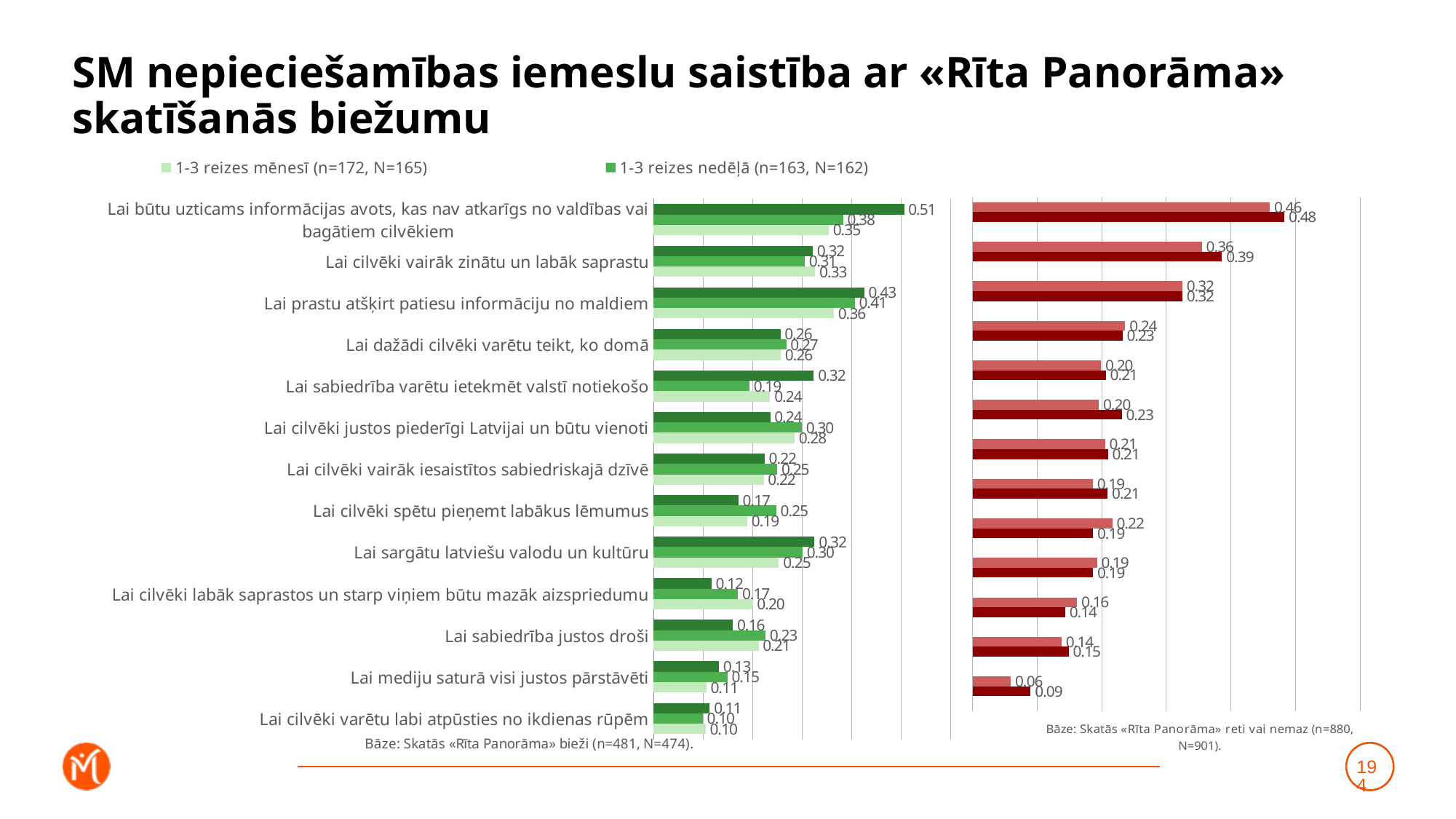
In the left-hand green chart, what is the value for '1-3 reizes mēnesī' for 'Lai prastu atšķirt patiesu informāciju no maldiem'? 0.36 In the left-hand green chart, which category has the lowest value for '1-3 reizes mēnesī'? Lai cilvēki varētu labi atpūsties no ikdienas rūpēm In the left-hand green chart, what is the value for '1-3 reizes nedēļā' for 'Lai būtu uzticams informācijas avots, kas nav atkarīgs no valdības vai bagātiem cilvēkiem'? 0.38 In the legend above the left-hand green chart, which series is shown in light green? 1-3 reizes mēnesī (n=172, N=165) How many series does the legend above the left-hand green chart list? 2 In the left-hand green chart, what is the difference between the '1-3 reizes mēnesī' value and the '1-3 reizes nedēļā' value for 'Lai sabiedrība varētu ietekmēt valstī notiekošo'? 0.05 In the left-hand green chart, what is the value for '1-3 reizes mēnesī' for 'Lai sabiedrība justos droši'? 0.21 In the left-hand green chart, which category has the highest value for '1-3 reizes nedēļā'? Lai prastu atšķirt patiesu informāciju no maldiem What kind of chart is the left-hand green chart? Bar chart How many categories are shown in the left-hand green chart? 13 In the right-hand red chart, what is the largest value shown? 0.48 In the left-hand green chart, for 'Lai cilvēki spētu pieņemt labākus lēmumus', which series has the larger value: '1-3 reizes nedēļā' or '1-3 reizes mēnesī'? 1-3 reizes nedēļā